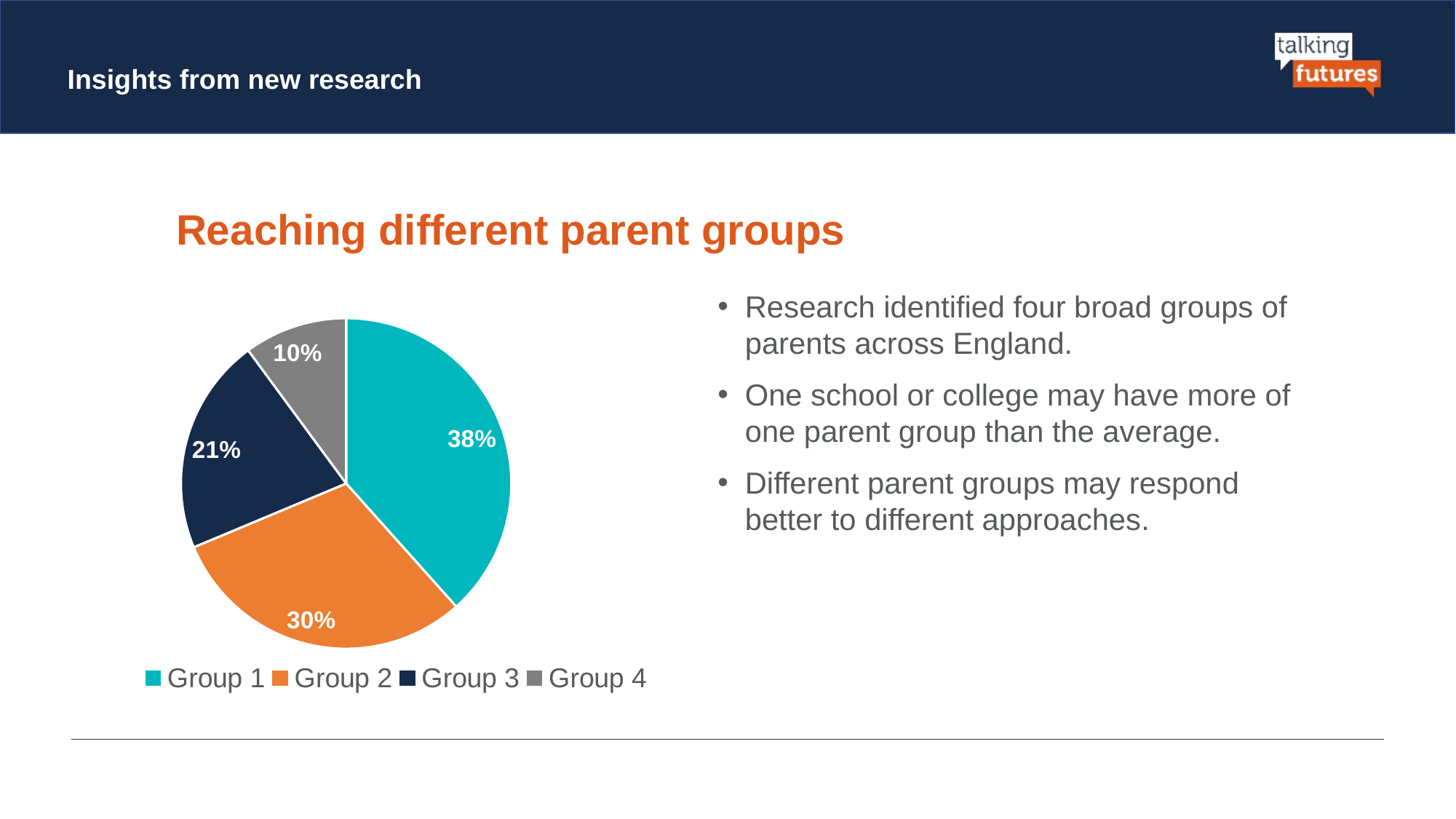
What share of the pie does Group 1 represent? 38% What share of the pie does Group 4 represent? 10% What is the difference in percentage points between Group 1 and Group 2? 8 How many groups are shown in the pie chart? 4 What share of the pie does Group 3 represent? 21% Which group has the smallest slice of the pie? Group 4 Which is larger, the share for Group 2 or the share for Group 3? Group 2 What colour is the slice for Group 2? orange What kind of chart is shown on the slide? pie chart What is the difference in percentage points between Group 3 and Group 4? 11 What share of the pie does Group 2 represent? 30% Which group has the largest slice of the pie? Group 1